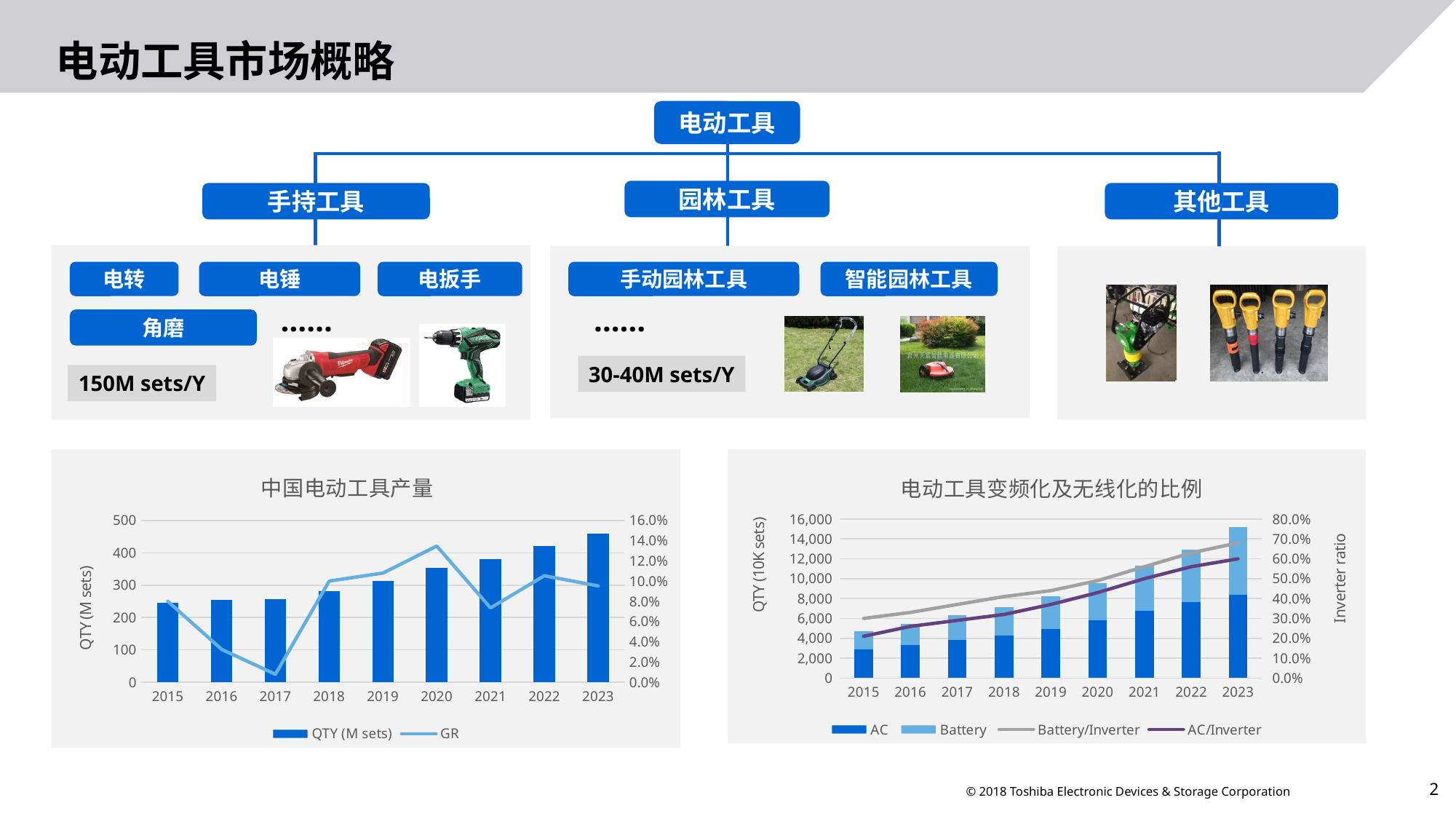
In the right chart 电动工具变频化及无线化的比例, how many series does the legend list? 4 In the left chart 中国电动工具产量, is the QTY (M sets) value for 2015 greater or less than 300? less In the right chart 电动工具变频化及无线化的比例, which year has the tallest stacked bar? 2023 In the right chart 电动工具变频化及无线化的比例, is the Battery/Inverter ratio for 2023 greater or less than 60.0%? greater In the left chart 中国电动工具产量, which year has the highest QTY (M sets) bar? 2023 What kind of chart is the left chart titled 中国电动工具产量? A bar chart combined with a line chart In the left chart 中国电动工具产量, how many series does the legend list? 2 In the left chart 中国电动工具产量, in which year is the GR line at its highest? 2020 In the left chart 中国电动工具产量, in which year is the GR line at its lowest? 2017 In the left chart 中国电动工具产量, how many years are shown on the x axis? 9 In the left chart 中国电动工具产量, do the QTY (M sets) bars generally rise or fall from 2015 to 2023? Rise In the left chart 中国电动工具产量, is the QTY (M sets) value for 2023 greater or less than 400? greater